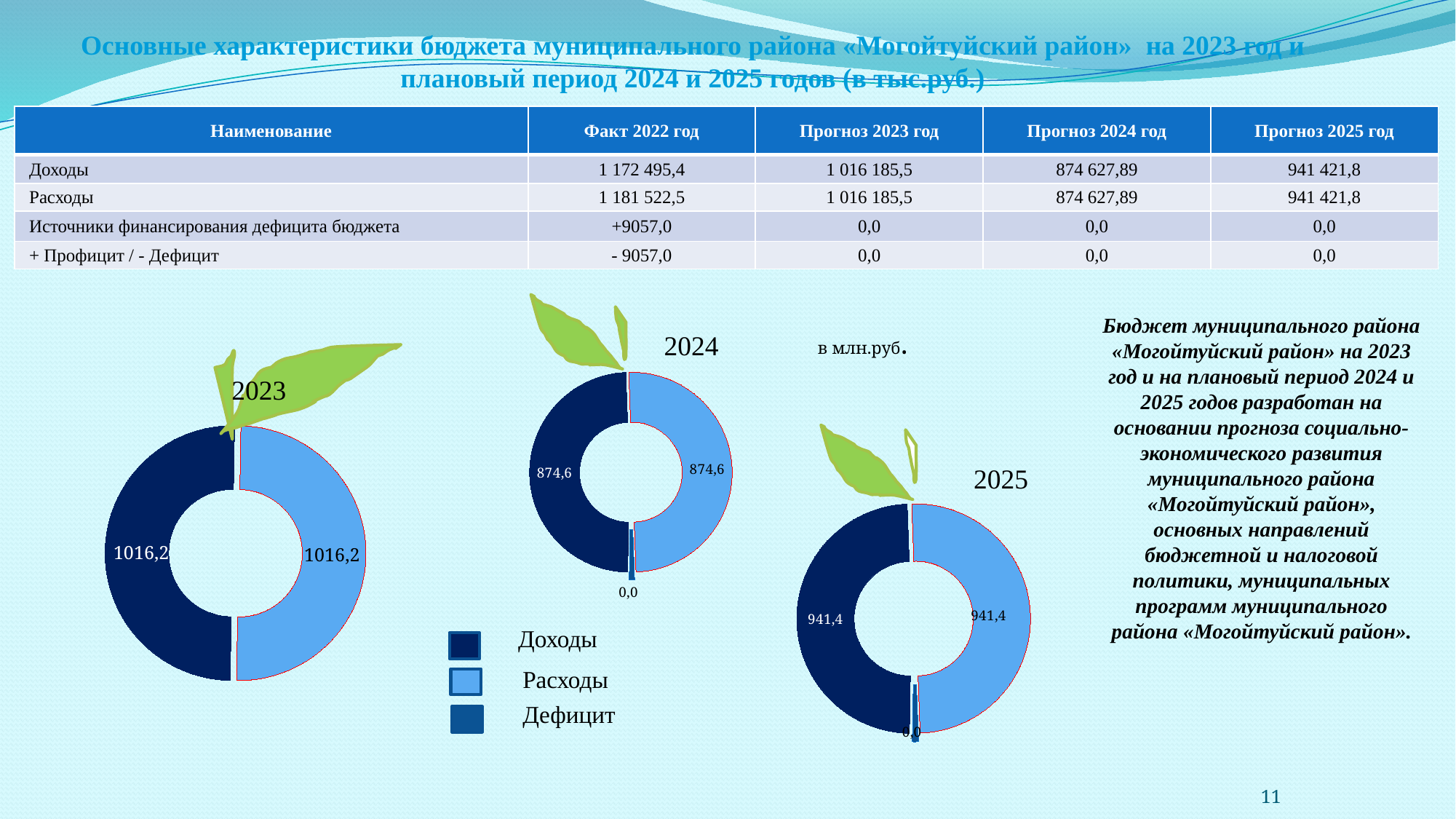
In the legend of the doughnut charts, which category is shown in the darkest navy colour? Доходы In the 2023 doughnut chart, what is the value shown for Расходы? 1016,2 In the 2025 doughnut chart, what is the value shown for Расходы? 941,4 In the 2025 doughnut chart, what is the value shown for Дефицит? 0,0 In the 2024 doughnut chart, what is the value shown for Дефицит? 0,0 In the 2025 doughnut chart, what share of the total do Доходы represent? 50% In the 2024 doughnut chart, what is the difference between Доходы and Расходы? 0,0 In the 2023 doughnut chart, what is the value shown for Доходы? 1016,2 How many entries does the legend list for the doughnut charts? 3 How many doughnut charts are shown on the slide? 3 What kind of chart is used to show the 2023, 2024 and 2025 budgets? Doughnut chart In the 2024 doughnut chart, what is the value shown for Доходы? 874,6